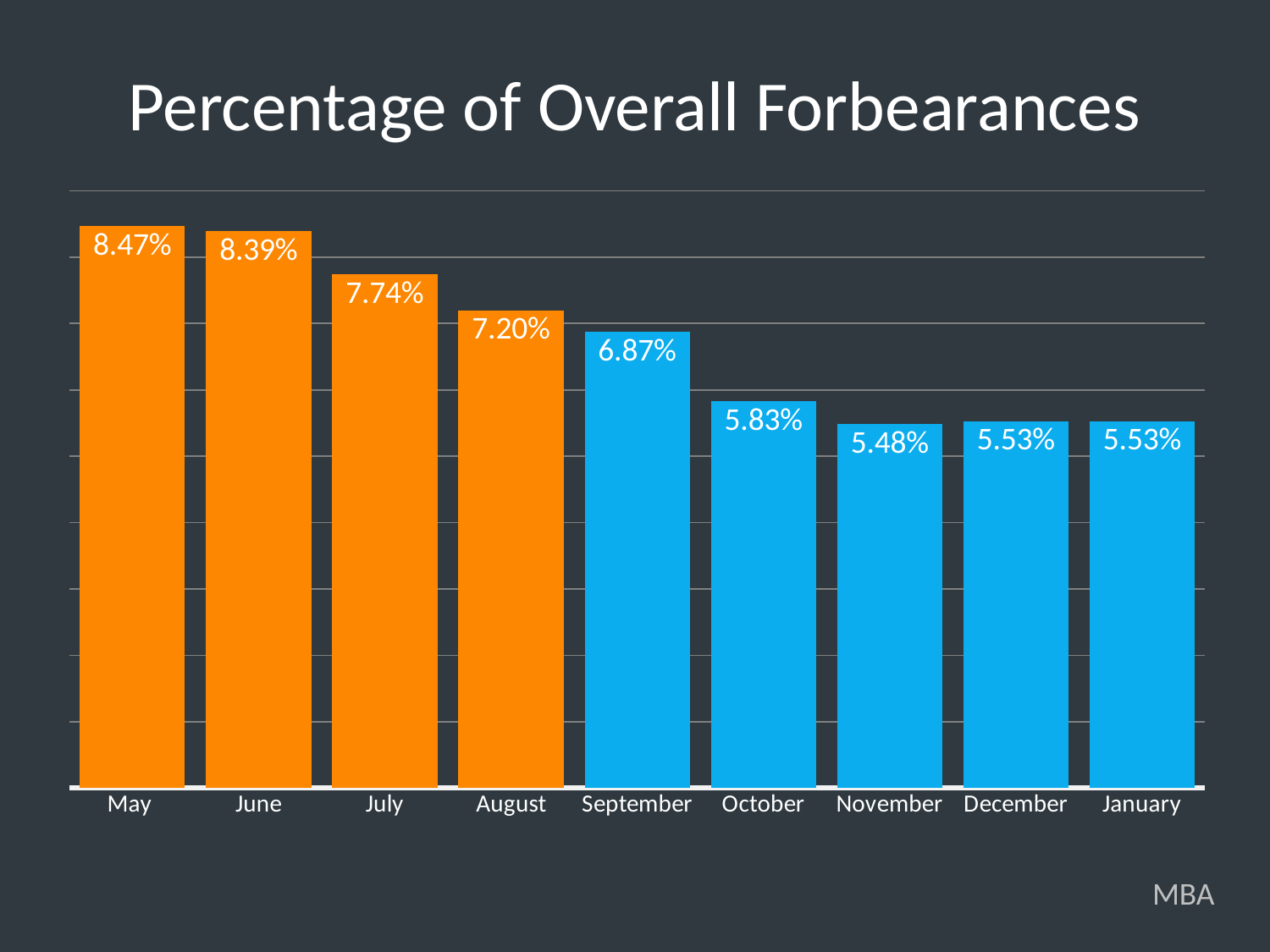
What kind of chart is shown on the slide? Bar chart Which is larger, the percentage for July or the percentage for October? July What is the difference between the percentage for October and the percentage for November? 0.35% What is the percentage of overall forbearances for January? 5.53% How many months are shown on the chart? 9 What is the difference between the percentage for May and the percentage for August? 1.27% Which month has the highest percentage of overall forbearances? May What is the title of the chart? Percentage of Overall Forbearances What is the percentage of overall forbearances for September? 6.87% Do the values generally rise or fall from May to November? Fall What is the percentage of overall forbearances for May? 8.47% Which month has the lowest percentage of overall forbearances? November